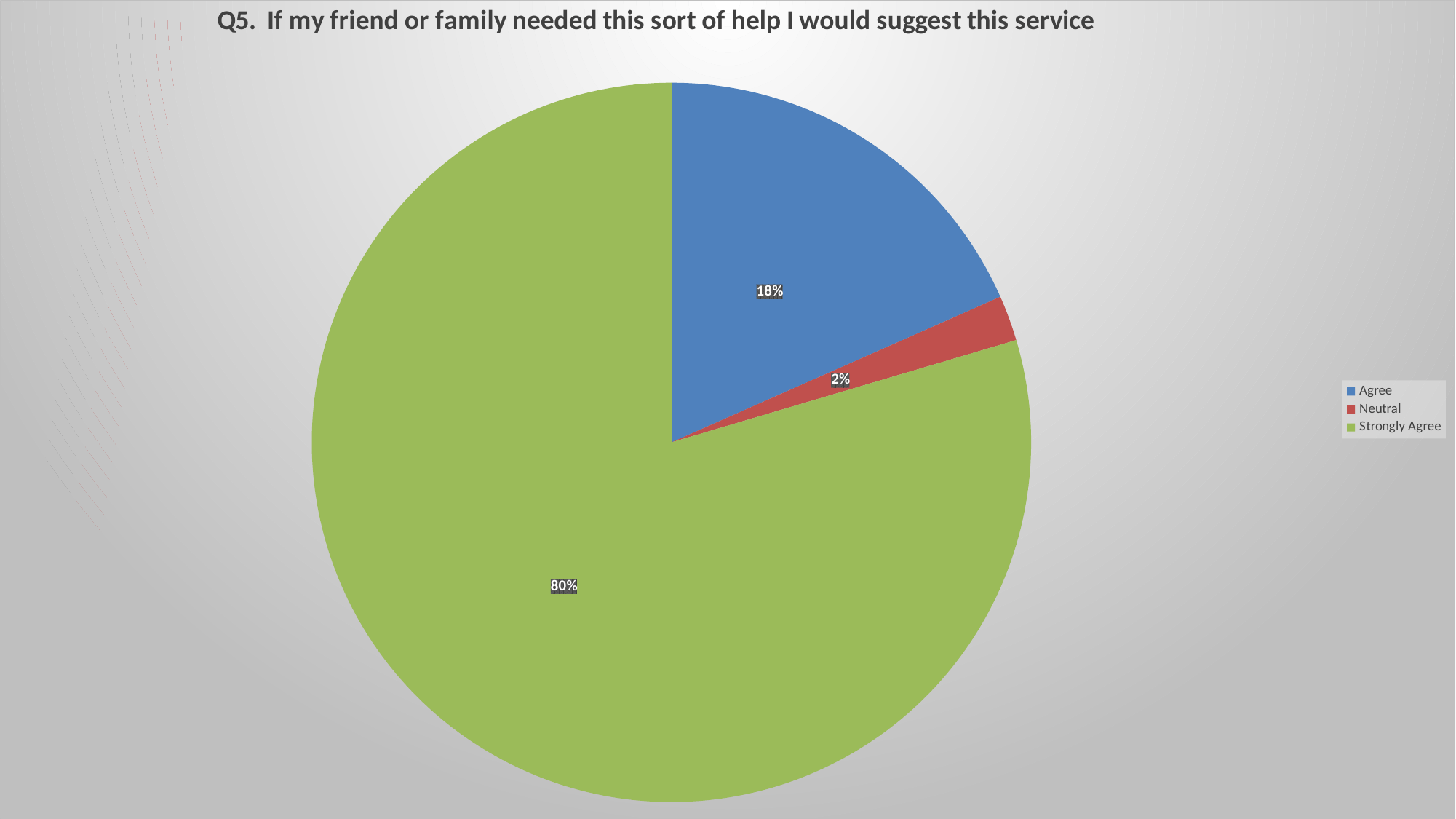
What percentage of the pie is labelled Strongly Agree? 80% What percentage of the pie is labelled Neutral? 2% How many categories does the legend list? 3 What colour is the Neutral slice? red Which category has the largest slice of the pie? Strongly Agree Which slice is larger, Agree or Neutral? Agree What is the difference in percentage points between the Strongly Agree and Agree slices? 62 What kind of chart is shown on the slide? pie chart What is the combined percentage of the Agree and Strongly Agree slices? 98% Which category has the smallest slice of the pie? Neutral What percentage of the pie is labelled Agree? 18% What is the title of the chart? Q5. If my friend or family needed this sort of help I would suggest this service